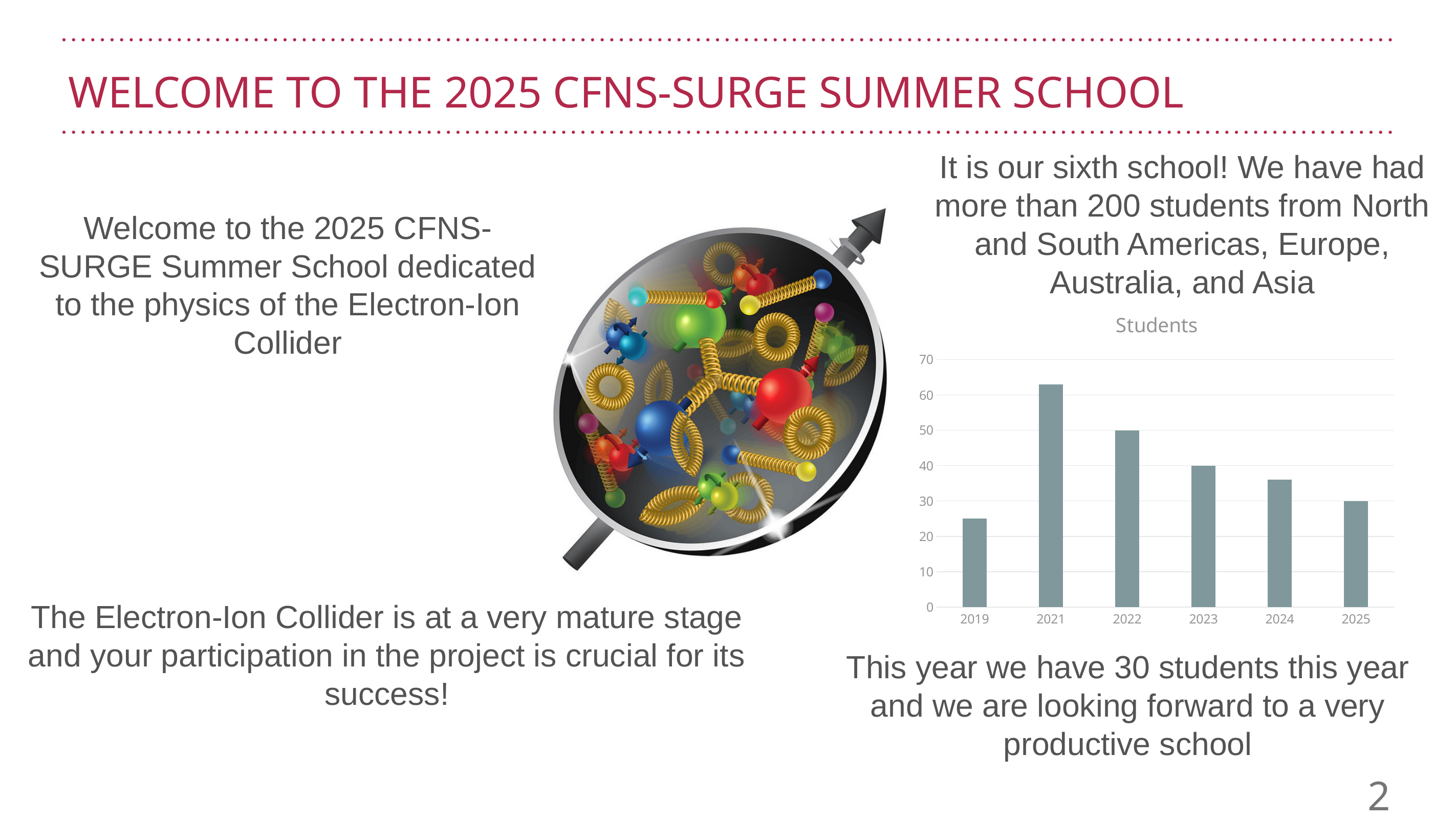
Do the number of students rise or fall from 2021 to 2025? fall Is the value for 2021 greater or less than 60? greater Which year has the highest number of students in the chart? 2021 What is the difference between the number of students in 2022 and in 2025? 20 What is the number of students for 2023? 40 What is the title of the chart? Students What is the number of students for 2022? 50 How many years are shown on the x axis of the Students chart? 6 What kind of chart is shown on the slide? bar chart Which year has the lowest number of students in the chart? 2019 Is the value for 2019 greater or less than 30? less What is the number of students for 2025? 30